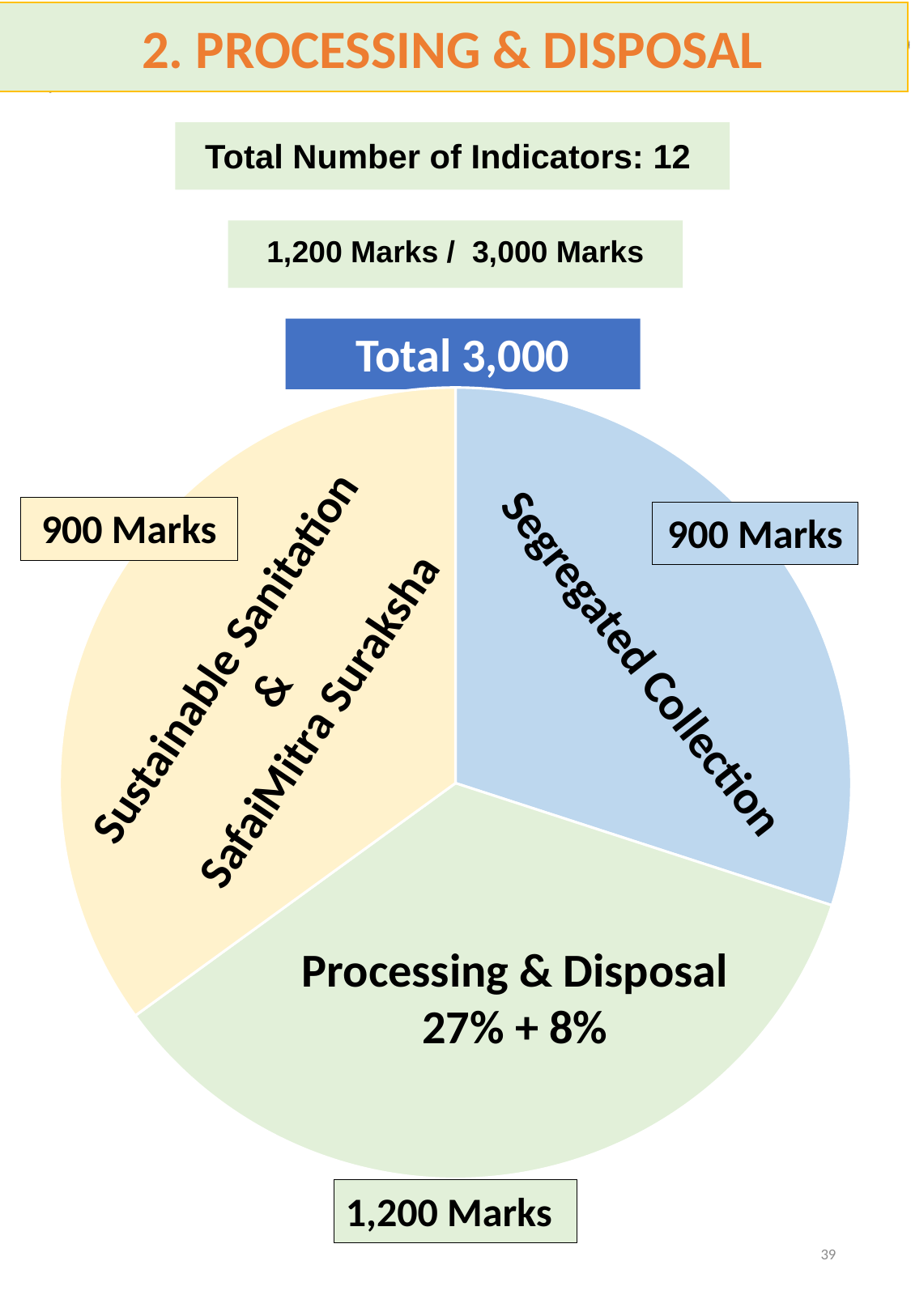
How many slices does the pie chart have? 3 What share of the total 3,000 marks does Processing & Disposal represent? 40% Which has more marks in the pie chart, Processing & Disposal or Segregated Collection? Processing & Disposal What colour is the Processing & Disposal slice in the pie chart? Green How many marks are allocated to Sustainable Sanitation & SafaiMitra Suraksha in the pie chart? 900 Marks Which slice of the pie chart has the highest number of marks? Processing & Disposal What share of the total 3,000 marks does Segregated Collection represent? 30% What is the total number of marks represented by the pie chart? 3,000 How many marks are allocated to Processing & Disposal in the pie chart? 1,200 Marks What is the difference in marks between Processing & Disposal and Segregated Collection? 300 Marks What kind of chart is shown on the slide? Pie chart How many marks are allocated to Segregated Collection in the pie chart? 900 Marks